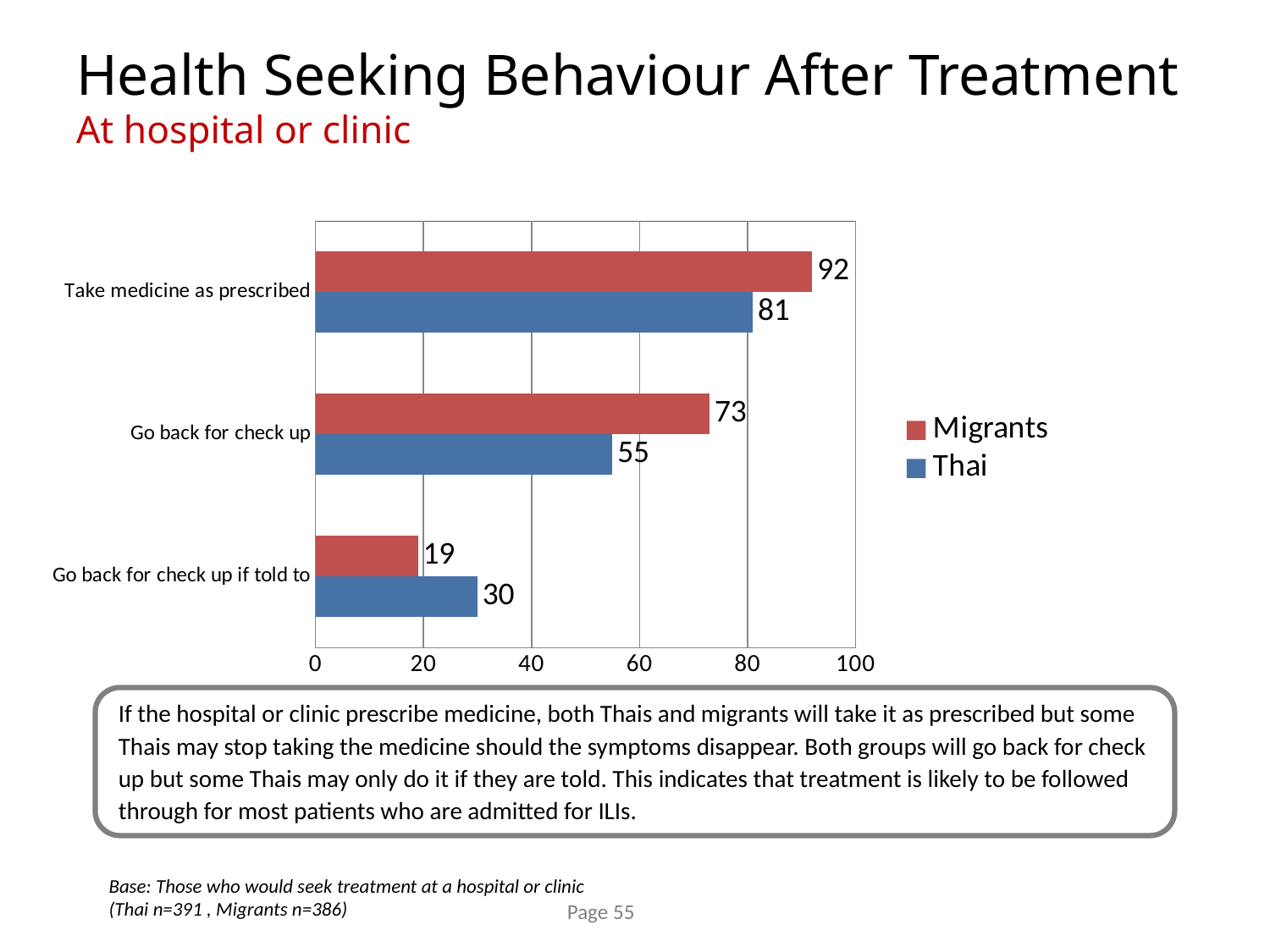
For 'Go back for check up if told to', which series has the larger value, Migrants or Thai? Thai What is the difference between the Migrants and Thai values for 'Go back for check up'? 18 Is the Thai value for 'Take medicine as prescribed' greater or less than 60? greater What is the value for Migrants for 'Take medicine as prescribed'? 92 How many series does the legend list? 2 What is the value for Thai for 'Go back for check up'? 55 What kind of chart is shown on the slide? Bar chart How many categories are shown on the chart? 3 What colour represents the Migrants series in the chart? Red Which category has the lowest value for Thai? Go back for check up if told to Which category has the highest value for Migrants? Take medicine as prescribed What is the value for Thai for 'Go back for check up if told to'? 30